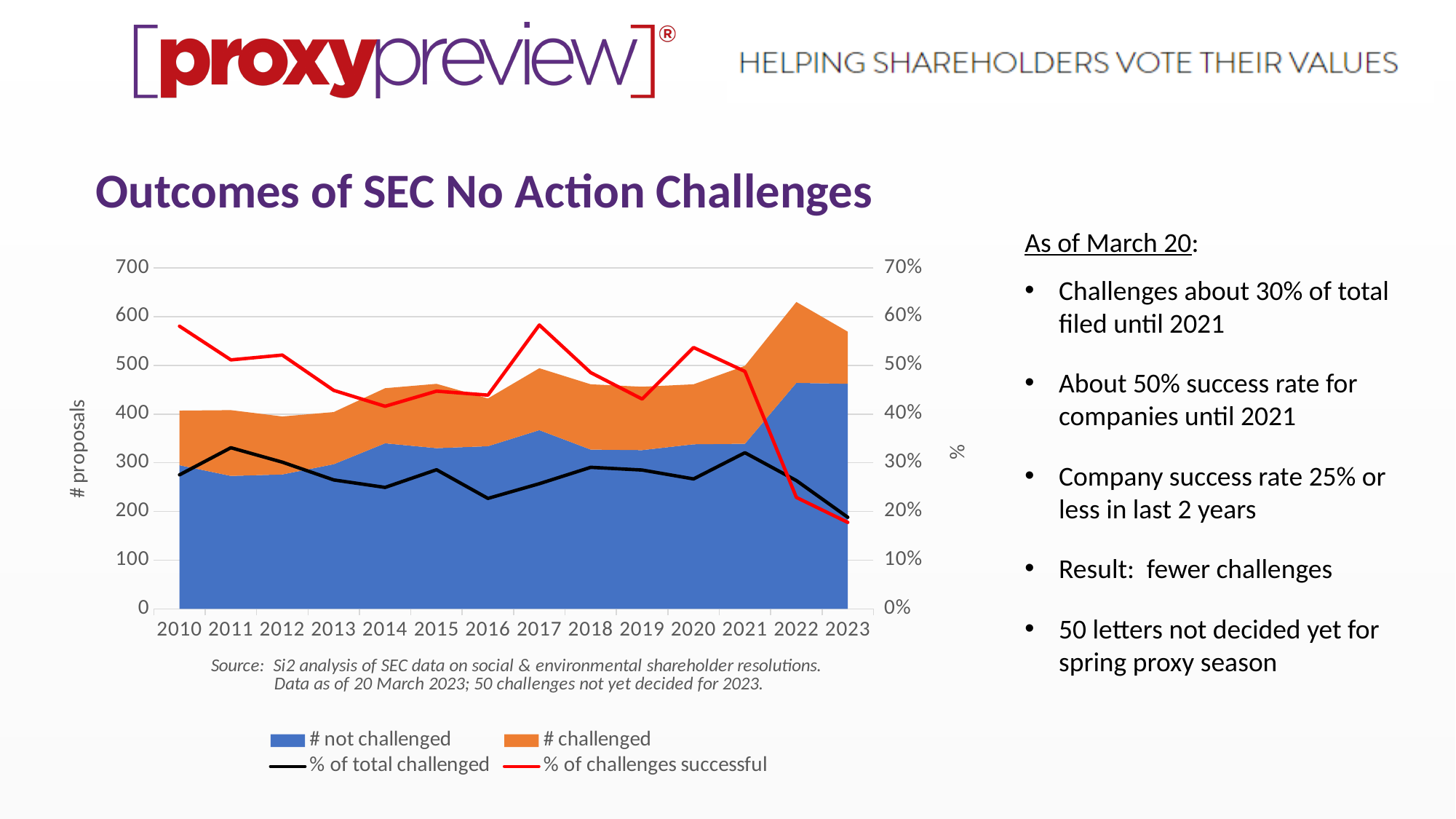
Is the value for # not challenged in 2017 greater or less than 300? greater What kind of chart is shown on the slide? stacked area chart with line series Does % of challenges successful rise or fall from 2021 to 2023? fall In which year does the stacked area (total proposals) reach its highest point? 2022 In which year is % of challenges successful at its lowest? 2023 What is the label on the left vertical axis? # proposals Is the value for % of challenges successful in 2023 greater or less than 20%? less Which year has the higher % of challenges successful, 2016 or 2017? 2017 How many series does the legend list? 4 How many years are shown on the x axis? 14 Is the value for % of challenges successful in 2010 greater or less than 50%? greater